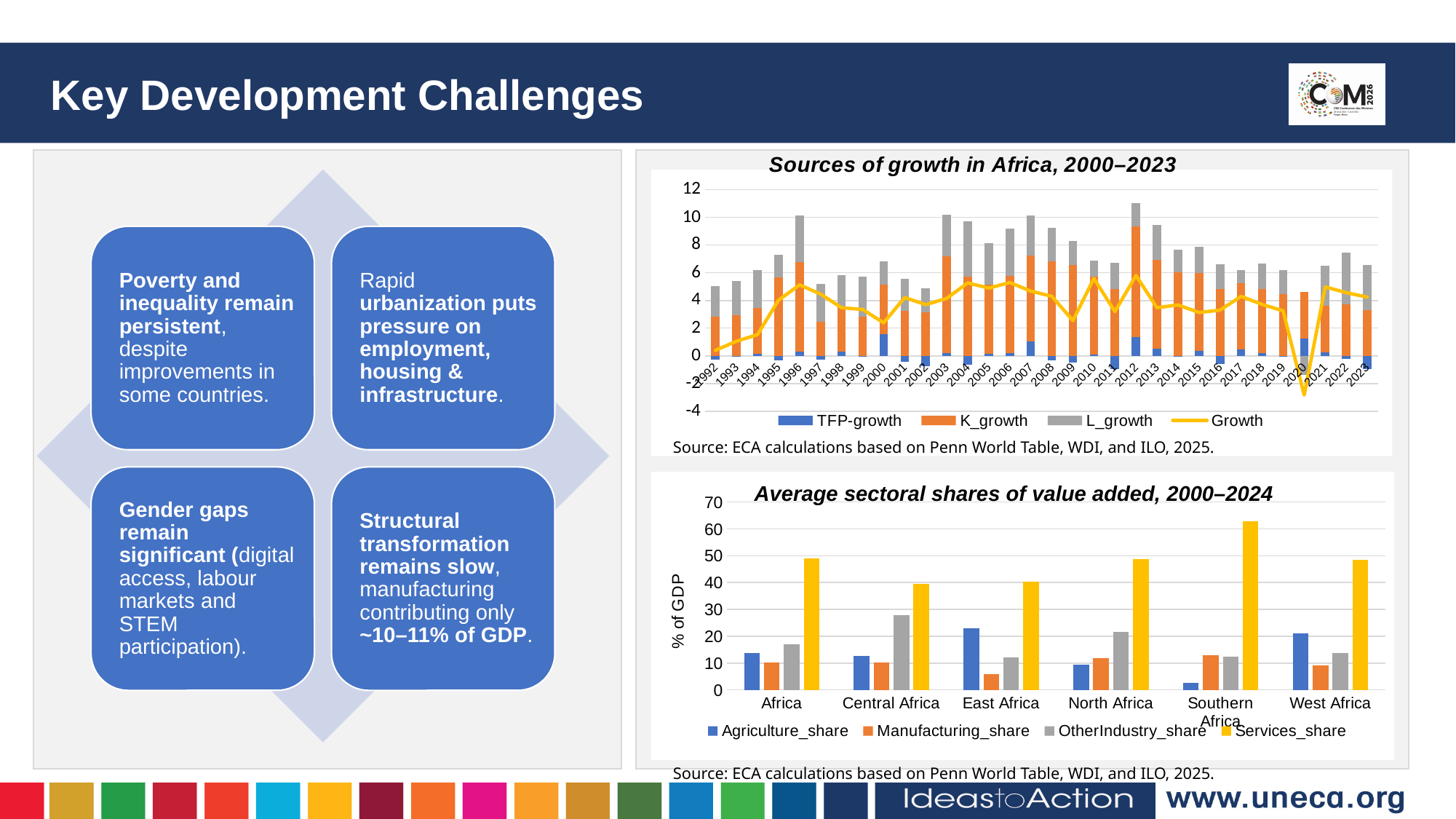
On the 'Sources of growth in Africa, 2000–2023' chart, is the Growth value for 2020 greater or less than 0? less On the 'Average sectoral shares of value added, 2000–2024' chart, which region has the lowest Agriculture_share? Southern Africa On the 'Average sectoral shares of value added, 2000–2024' chart, which is larger: the OtherIndustry_share for Central Africa or for North Africa? Central Africa On the 'Sources of growth in Africa, 2000–2023' chart, which year has the tallest stacked bar? 2012 On the 'Sources of growth in Africa, 2000–2023' chart, in which year does the Growth line reach its lowest point? 2020 On the 'Average sectoral shares of value added, 2000–2024' chart, how many regions are shown on the x axis? 6 On the 'Sources of growth in Africa, 2000–2023' chart, what colour is the Growth line? Yellow On the 'Average sectoral shares of value added, 2000–2024' chart, what kind of chart is shown? Bar chart On the 'Average sectoral shares of value added, 2000–2024' chart, is the Services_share for Africa greater or less than 40? greater On the 'Sources of growth in Africa, 2000–2023' chart, how many series does the legend list? 4 On the 'Average sectoral shares of value added, 2000–2024' chart, what is the label on the y axis? % of GDP On the 'Average sectoral shares of value added, 2000–2024' chart, which region has the highest Services_share? Southern Africa